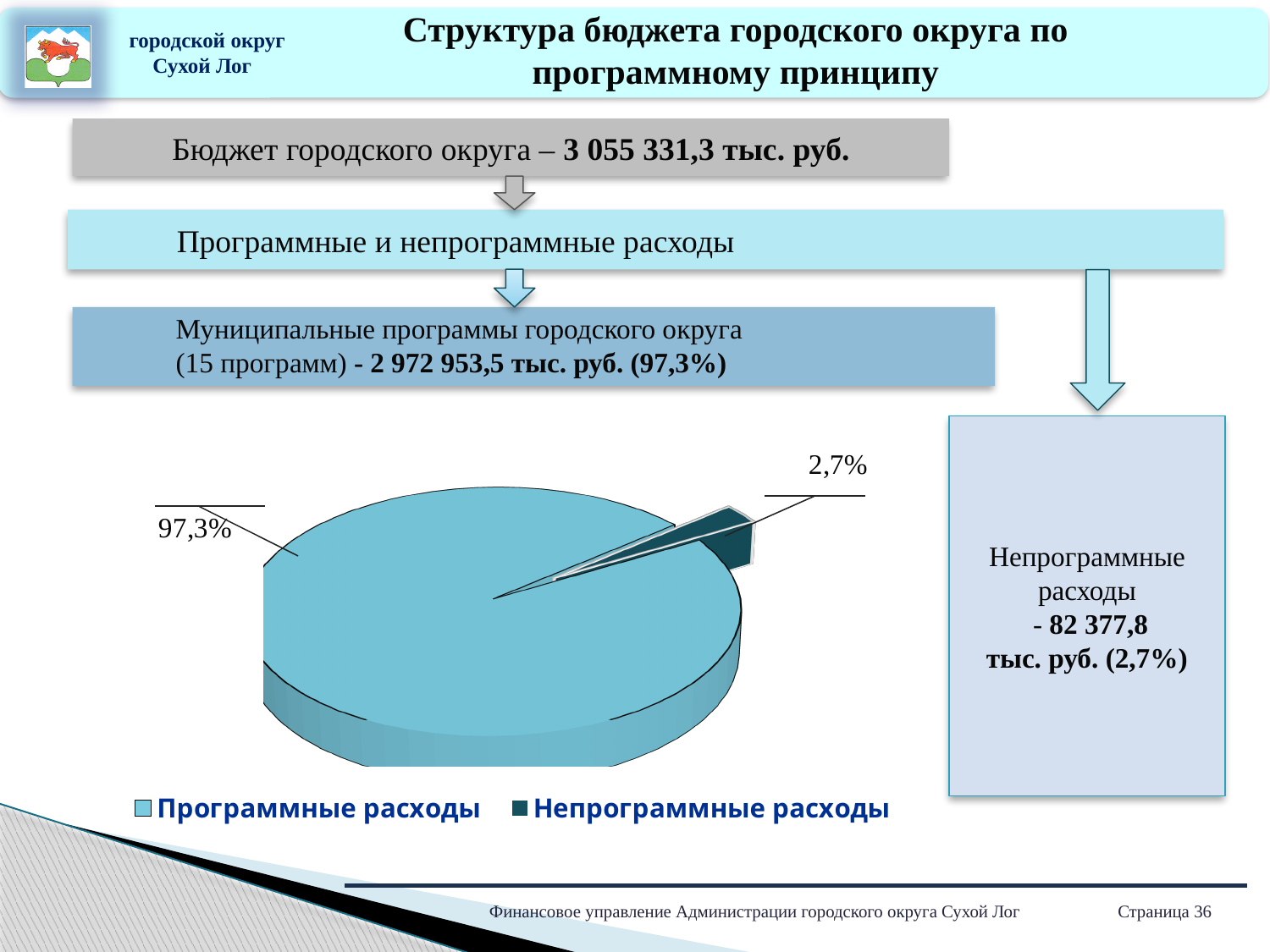
What is the total of the two pie slice percentages? 100% How many entries does the legend list? 2 Which slice of the pie is the largest? Программные расходы What kind of chart is shown on the slide? pie chart Which is larger: the Программные расходы slice or the Непрограммные расходы slice? Программные расходы How many slices does the pie chart have? 2 What share of the pie does Непрограммные расходы take? 2,7% Which legend entry is shown in the dark teal colour? Непрограммные расходы What share of the pie does Программные расходы take? 97,3% Which slice of the pie is the smallest? Непрограммные расходы Which legend entry is shown in the light blue colour? Программные расходы What is the difference in percentage points between the Программные расходы slice and the Непрограммные расходы slice? 94,6